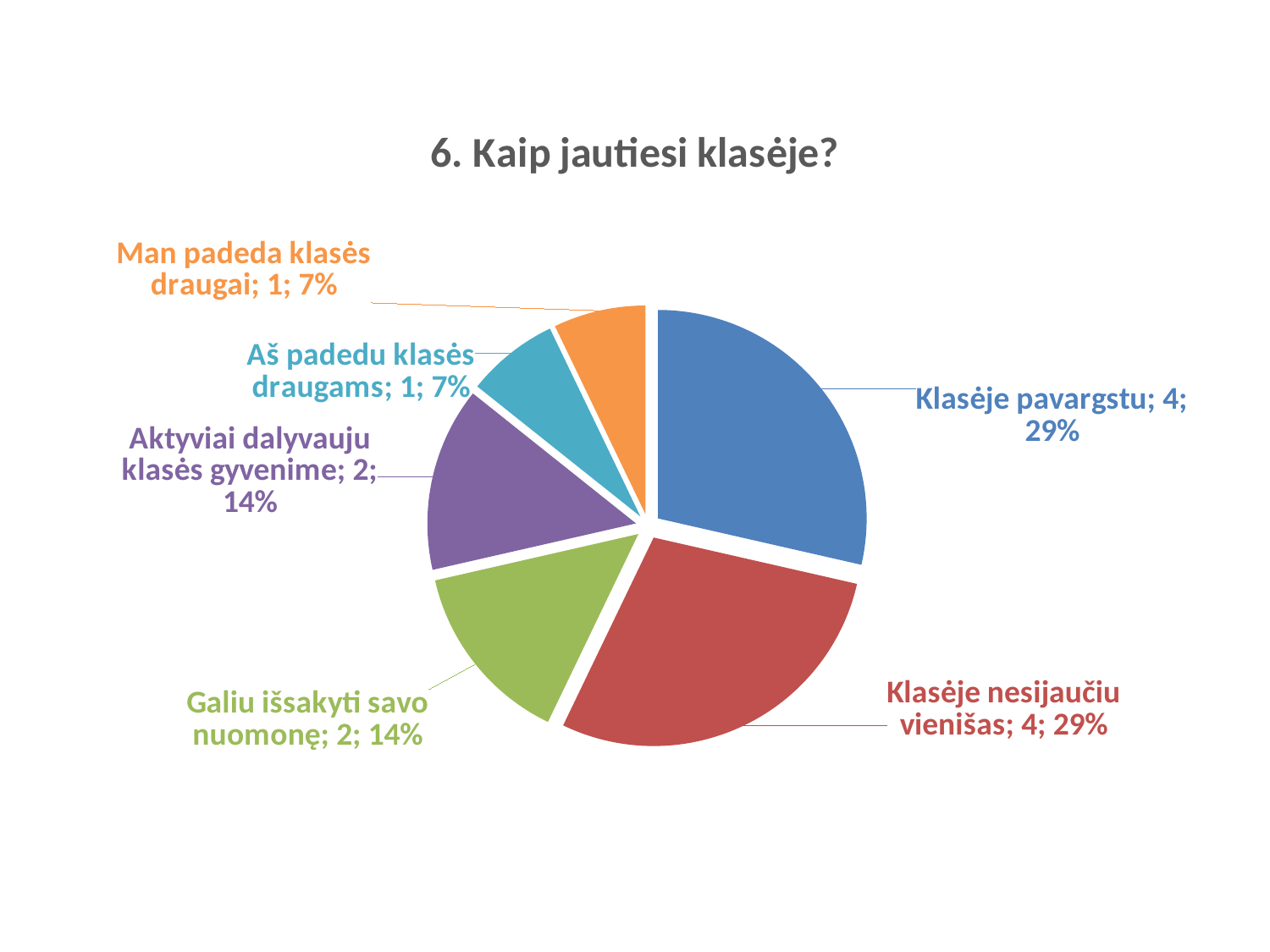
What colour is the slice for "Klasėje nesijaučiu vienišas"? red What is the count shown for "Man padeda klasės draugai"? 1 What share of the pie does "Galiu išsakyti savo nuomonę" represent? 14% What is the count shown for "Aktyviai dalyvauju klasės gyvenime"? 2 What share of the pie does "Aš padedu klasės draugams" represent? 7% What is the difference between the count for "Klasėje nesijaučiu vienišas" and the count for "Aš padedu klasės draugams"? 3 What share of the pie does "Klasėje pavargstu" represent? 29% How many slices does the pie chart have? 6 What type of chart is shown on the slide? pie chart Which is larger: the count for "Klasėje pavargstu" or the count for "Galiu išsakyti savo nuomonę"? Klasėje pavargstu What is the count shown for "Klasėje nesijaučiu vienišas"? 4 What is the title of the chart? 6. Kaip jautiesi klasėje?